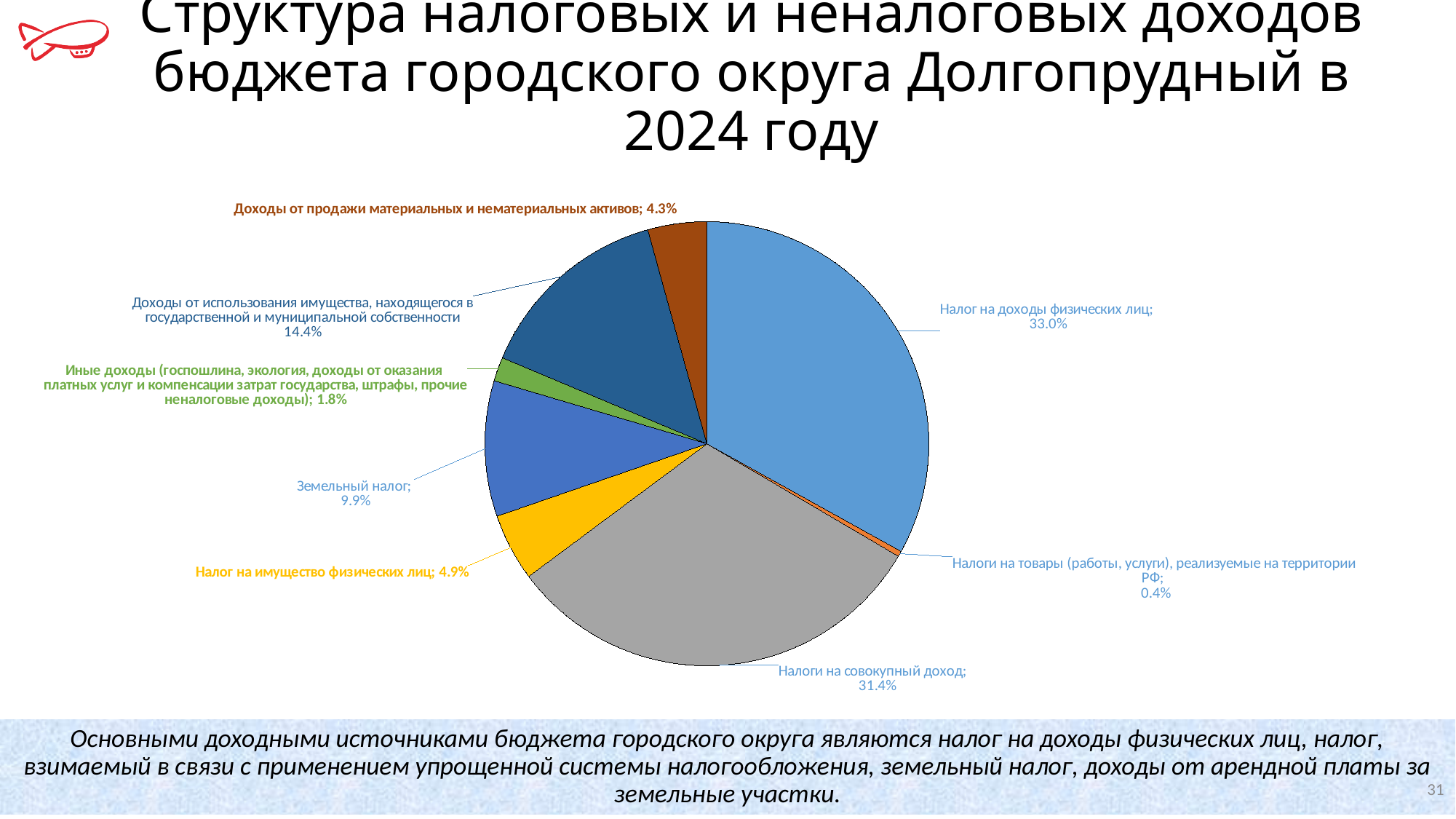
What share of the pie is Налог на доходы физических лиц? 33.0% What is the difference in percentage points between Налог на доходы физических лиц and Налоги на совокупный доход? 1.6 What is the value shown for Налоги на совокупный доход? 31.4% Which category has the smallest share of the pie? Налоги на товары (работы, услуги), реализуемые на территории РФ Which category has the largest share of the pie? Налог на доходы физических лиц What is the difference in percentage points between Доходы от использования имущества and Доходы от продажи материальных и нематериальных активов? 10.1 What is the value shown for Доходы от использования имущества, находящегося в государственной и муниципальной собственности? 14.4% Which is larger: Земельный налог or Налог на имущество физических лиц? Земельный налог What year does the chart title say the budget revenue structure refers to? 2024 What is the value shown for Земельный налог? 9.9% What kind of chart is shown on the slide? pie chart How many slices does the pie chart have? 8